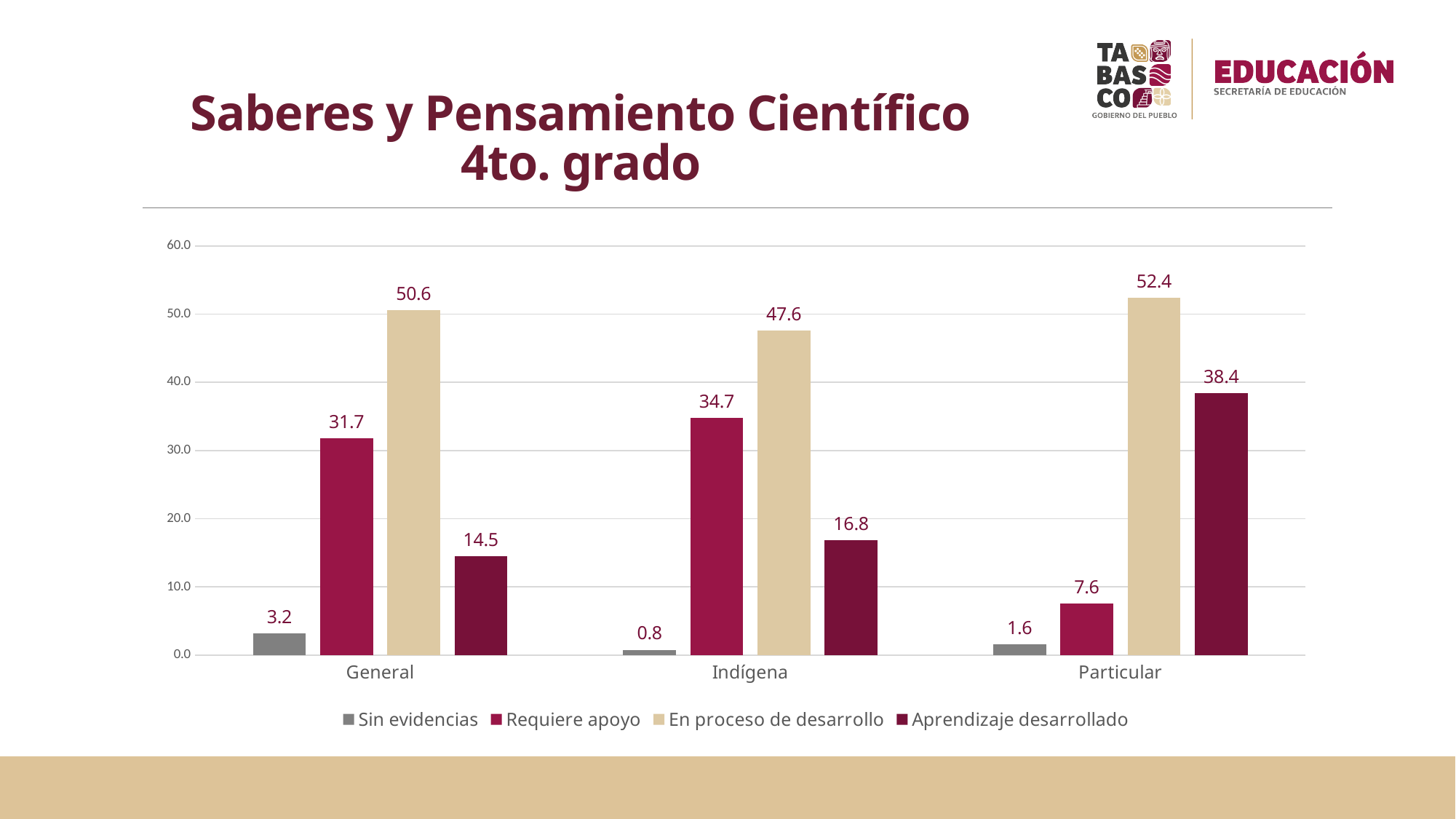
What is the value for "En proceso de desarrollo" in the General category? 50.6 What is the title of the slide? Saberes y Pensamiento Científico 4to. grado Which is larger: "Requiere apoyo" for General or "Requiere apoyo" for Particular? General What is the value for "Sin evidencias" in the Indígena category? 0.8 What is the value for "Aprendizaje desarrollado" in the Particular category? 38.4 What is the difference between the "En proceso de desarrollo" values for Particular and Indígena? 4.8 How many categories are shown on the x axis? 3 What kind of chart is shown on the slide? Bar chart Which category has the highest value for "Requiere apoyo"? Indígena Which category has the lowest value for "Aprendizaje desarrollado"? General Does the value for "Sin evidencias" rise or fall from General to Indígena? Fall How many series does the legend list? 4